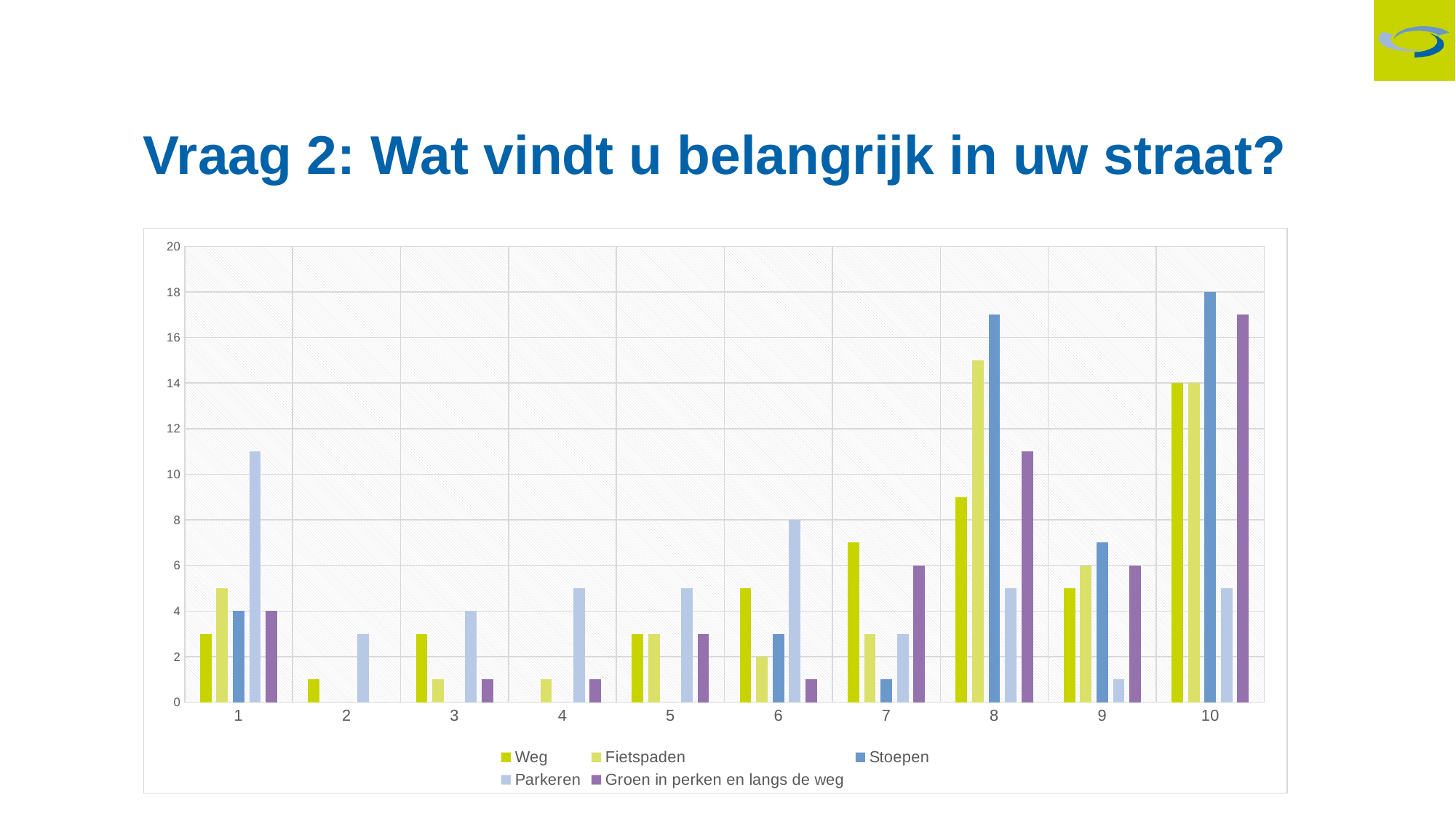
At category 8, which is larger: Stoepen or Fietspaden? Stoepen What is the value for Fietspaden at category 9? 6 What is the difference between Stoepen and Weg at category 10? 4 At which category does the Parkeren series reach its highest value? 1 Is the value for Parkeren at category 1 greater or less than 10? greater Is the value for Stoepen at category 8 greater or less than 16? greater How many categories are shown on the x axis? 10 How many series does the legend list? 5 What is the value for Parkeren at category 6? 8 What is the value for Stoepen at category 10? 18 What is the value for Weg at category 10? 14 At which category does the Stoepen series reach its highest value? 10